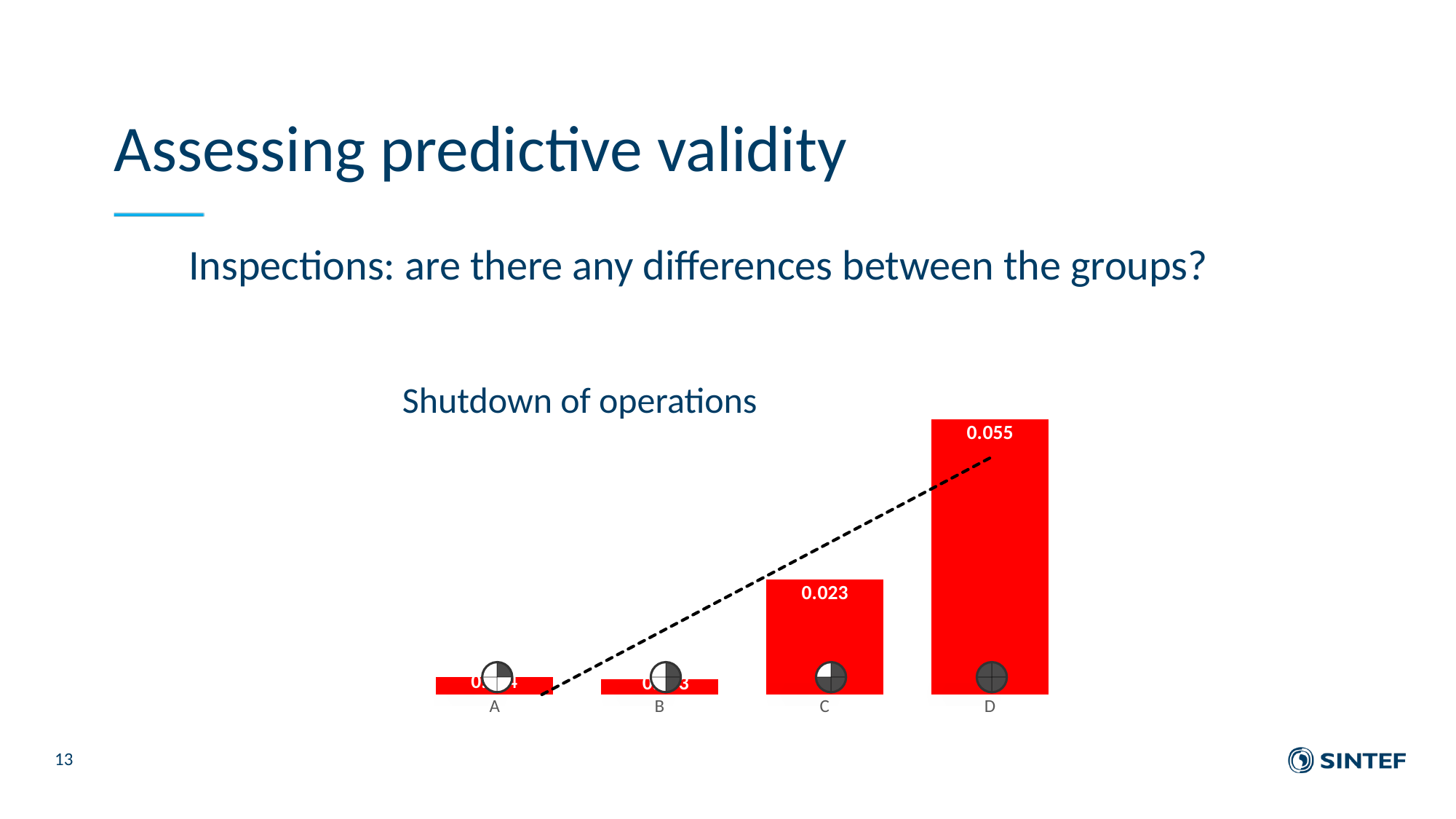
Which is larger in the Shutdown of operations chart, the value for B or the value for C? C What is the value for category C in the Shutdown of operations chart? 0.023 How many categories are shown in the Shutdown of operations chart? 4 Which is larger in the Shutdown of operations chart, the value for C or the value for D? D What is the title of the chart on the slide? Shutdown of operations What is the difference between the values for D and C in the Shutdown of operations chart? 0.032 Do the values in the Shutdown of operations chart rise or fall from A to D? Rise What kind of chart is the Shutdown of operations chart? Bar chart Which category has the highest value in the Shutdown of operations chart? D What colour are the bars in the Shutdown of operations chart? Red What is the value for category D in the Shutdown of operations chart? 0.055 Which is larger in the Shutdown of operations chart, the value for A or the value for D? D